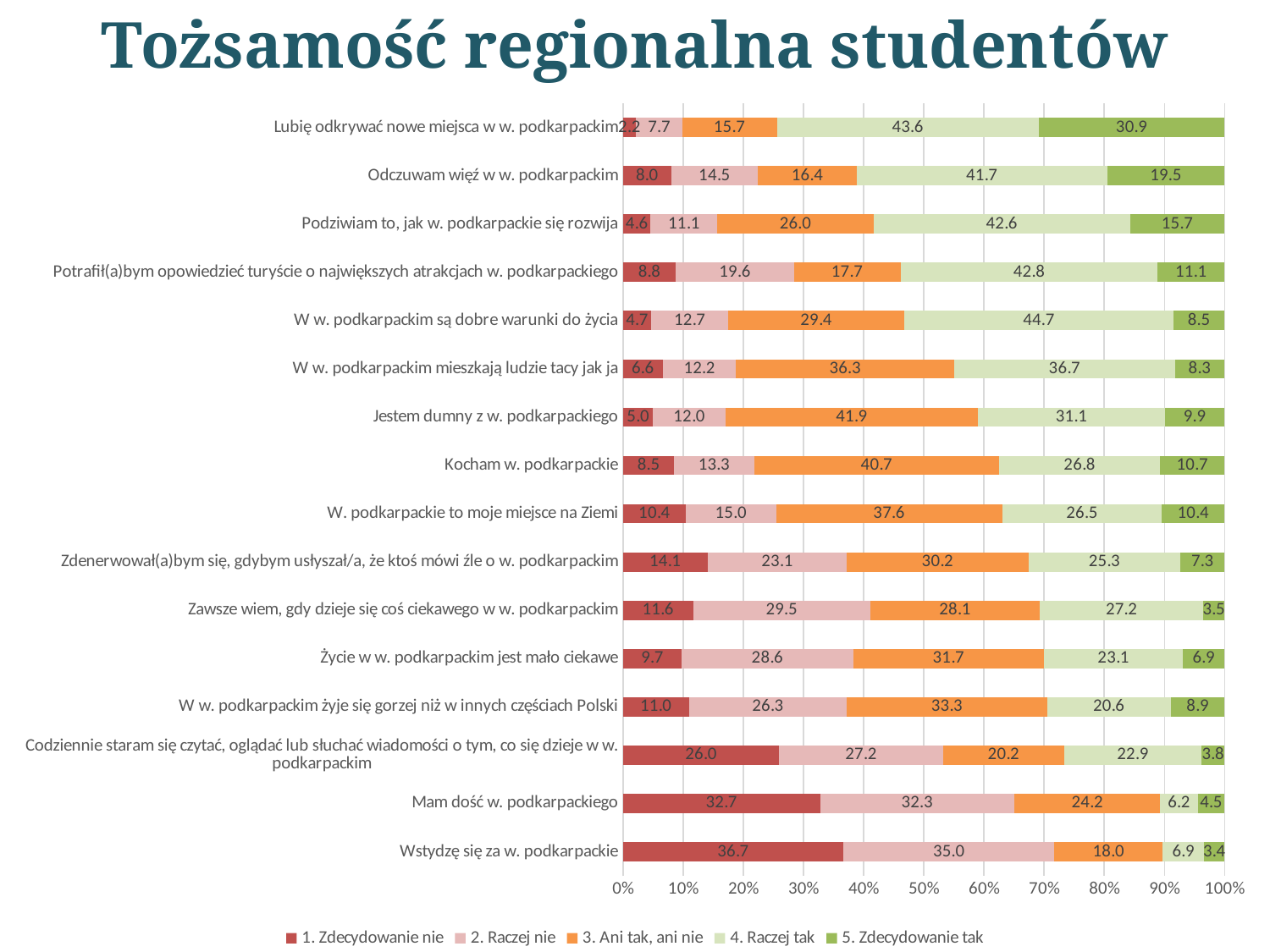
Which statement has the highest value for "1. Zdecydowanie nie"? Wstydzę się za w. podkarpackie How many statements (categories) are plotted on the chart? 16 What is the value of "3. Ani tak, ani nie" for "Jestem dumny z w. podkarpackiego"? 41.9 What is the value of "5. Zdecydowanie tak" for "Lubię odkrywać nowe miejsca w w. podkarpackim"? 30.9 For "Mam dość w. podkarpackiego", which is larger: "1. Zdecydowanie nie" or "3. Ani tak, ani nie"? 1. Zdecydowanie nie How many series does the legend list? 5 What kind of chart is shown on the slide? Stacked bar chart What is the difference between the "4. Raczej tak" and "5. Zdecydowanie tak" values for "Lubię odkrywać nowe miejsca w w. podkarpackim"? 12.7 Which statement has the highest value for "5. Zdecydowanie tak"? Lubię odkrywać nowe miejsca w w. podkarpackim What is the combined value of "4. Raczej tak" and "5. Zdecydowanie tak" for "Odczuwam więź w w. podkarpackim"? 61.2 What is the title of the slide? Tożsamość regionalna studentów What is the value of "1. Zdecydowanie nie" for "Wstydzę się za w. podkarpackie"? 36.7